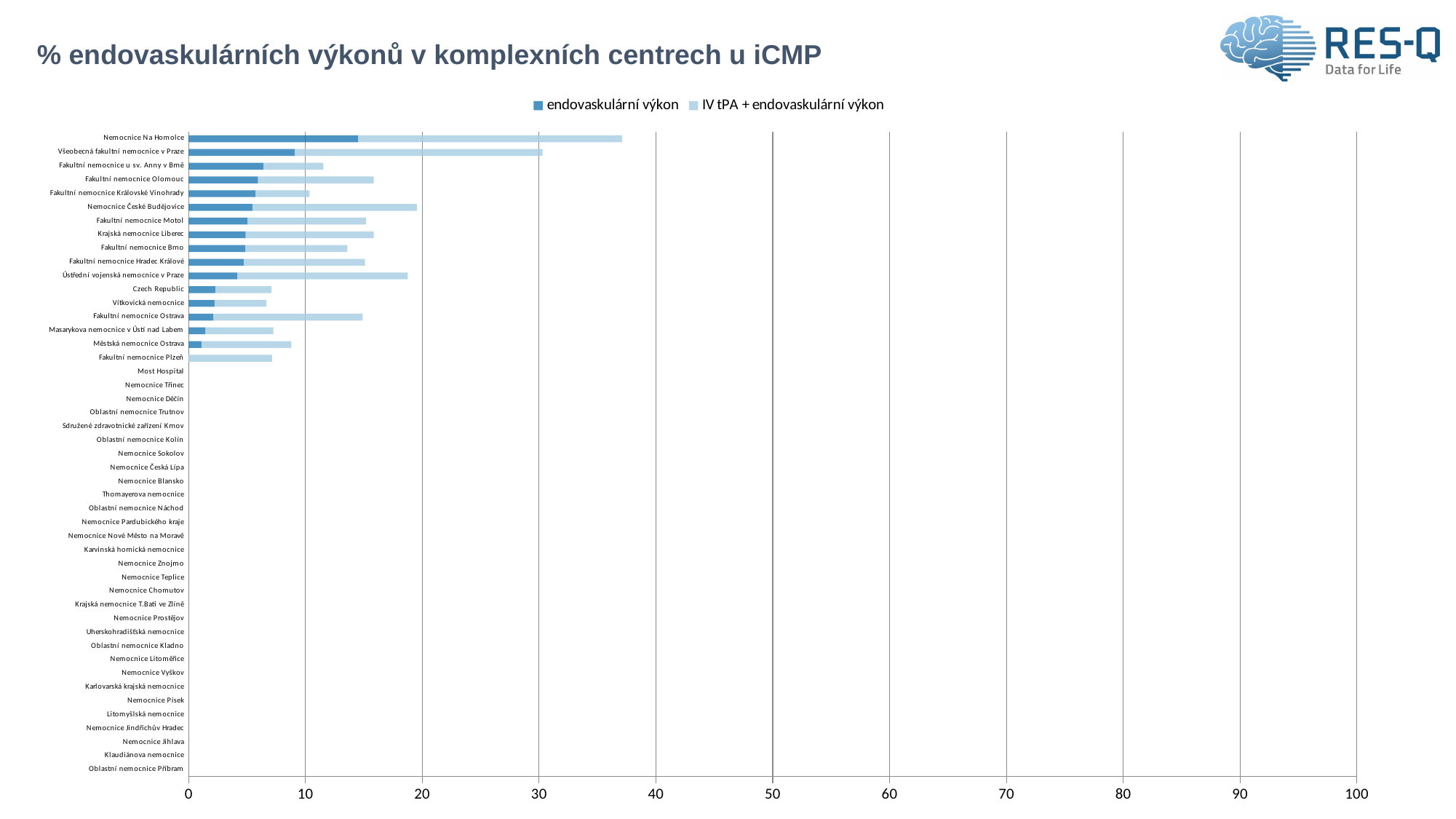
Is the total bar for Fakultní nemocnice Ostrava greater or less than 10? greater How many series does the legend list? 2 What kind of chart is shown on the slide? bar chart Is the total bar for Czech Republic greater or less than 10? less What is the highest value shown on the horizontal axis? 100 Which has the larger endovaskulární výkon value: Nemocnice Na Homolce or Všeobecná fakultní nemocnice v Praze? Nemocnice Na Homolce Is the endovaskulární výkon value for Nemocnice Na Homolce greater or less than 10? greater What are the two series named in the legend? endovaskulární výkon; IV tPA + endovaskulární výkon Which hospital has the longest total bar? Nemocnice Na Homolce Which has the longer total bar: Nemocnice České Budějovice or Fakultní nemocnice Olomouc? Nemocnice České Budějovice What is the title of the chart? % endovaskulárních výkonů v komplexních centrech u iCMP